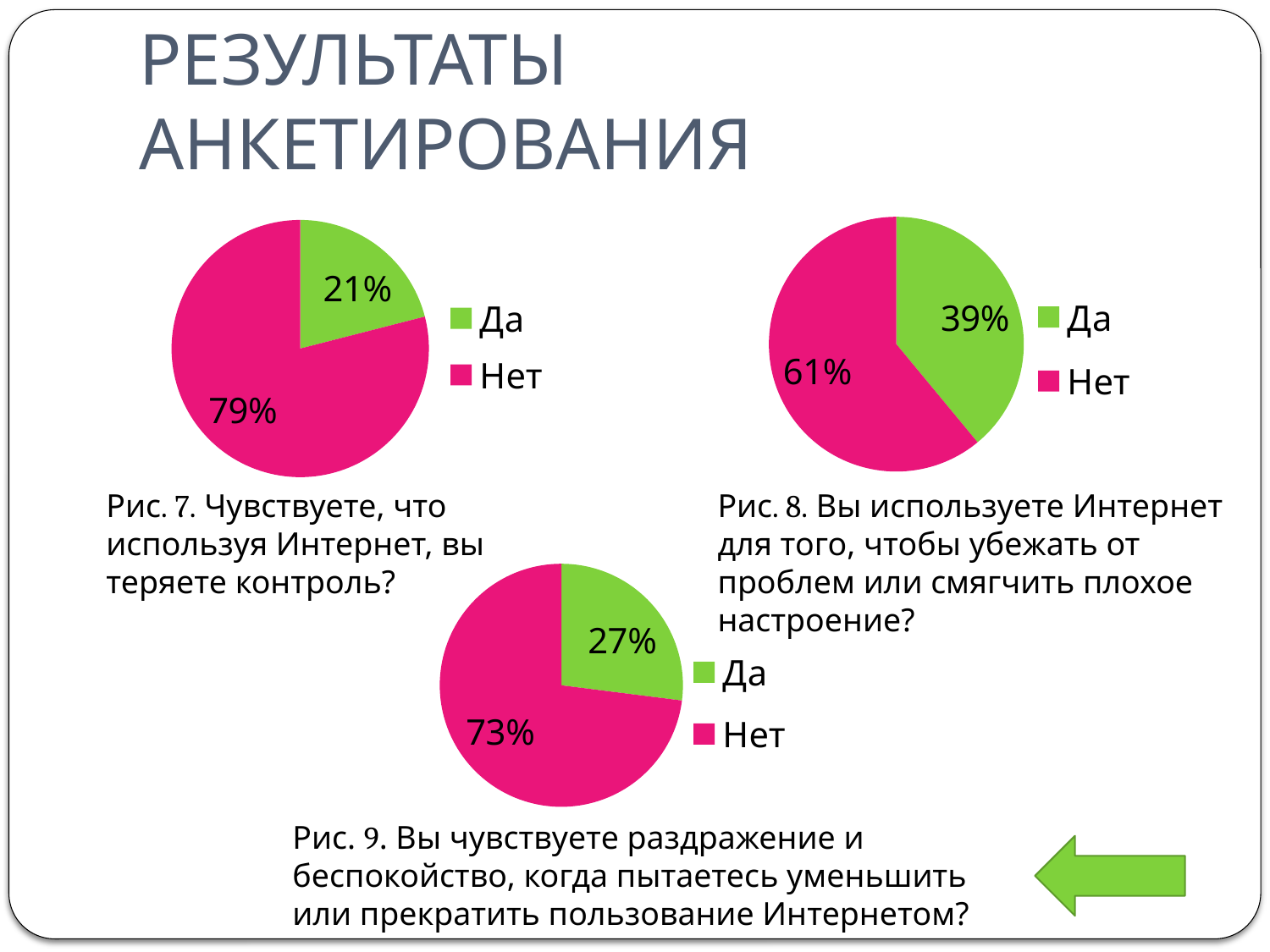
In the pie chart for Рис. 9 (bottom), what percentage answered Да? 27% In the pie chart for Рис. 9 (bottom), is the Да share larger or smaller than the Нет share? smaller What type of chart is used for Рис. 7 (top left)? pie chart In the pie chart for Рис. 8 (top right), which answer has the larger share? Нет In the pie chart for Рис. 8 (top right), which colour represents Да? green In the pie chart for Рис. 8 (top right), what percentage answered Да? 39% In the pie chart for Рис. 7 (top left), what is the difference between the Нет and Да shares? 58% In the pie chart for Рис. 8 (top right), what percentage answered Нет? 61% In the pie chart for Рис. 7 (top left), what percentage answered Да? 21% In the pie chart for Рис. 7 (top left), what percentage answered Нет? 79% In the pie chart for Рис. 9 (bottom), what percentage answered Нет? 73% How many entries does the legend of the Рис. 9 (bottom) chart list? 2